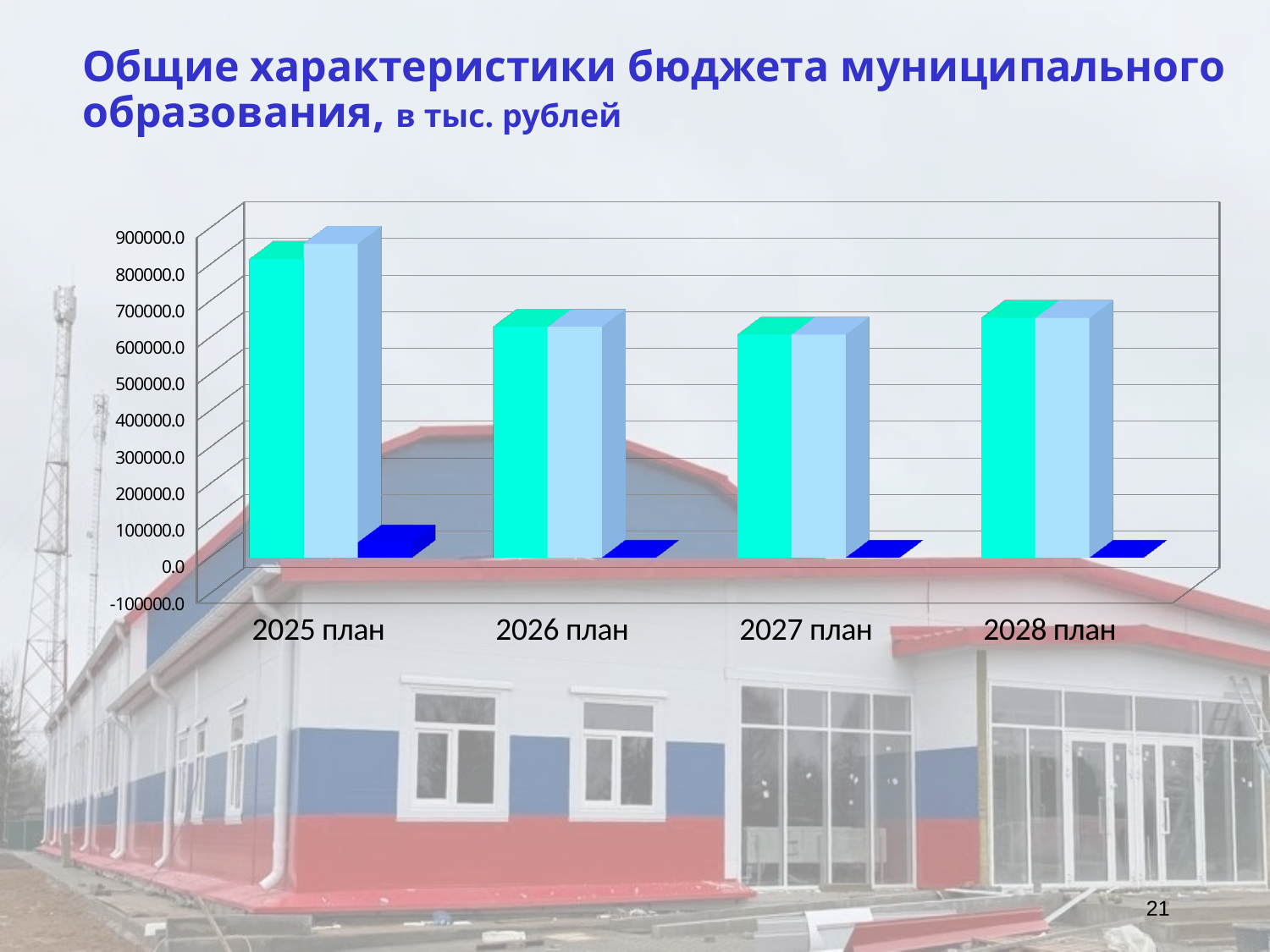
Is the value of the cyan bar for 2025 план greater or less than 800000.0? greater What is the highest value labelled on the vertical axis of the chart? 900000.0 How many bars are plotted for each category in the chart? 3 How many categories are shown along the x axis of the chart? 4 Is the value of the light blue bar for 2026 план greater or less than 700000.0? less Is the value of the cyan bar for 2027 план greater or less than 500000.0? greater What kind of chart is shown on the slide? bar chart Which category has the tallest bars in the chart? 2025 план Which is larger, the light blue bar for 2028 план or the light blue bar for 2027 план? 2028 план Which is larger, the cyan bar for 2025 план or the cyan bar for 2026 план? 2025 план In what units does the slide title say the budget figures are given? в тыс. рублей